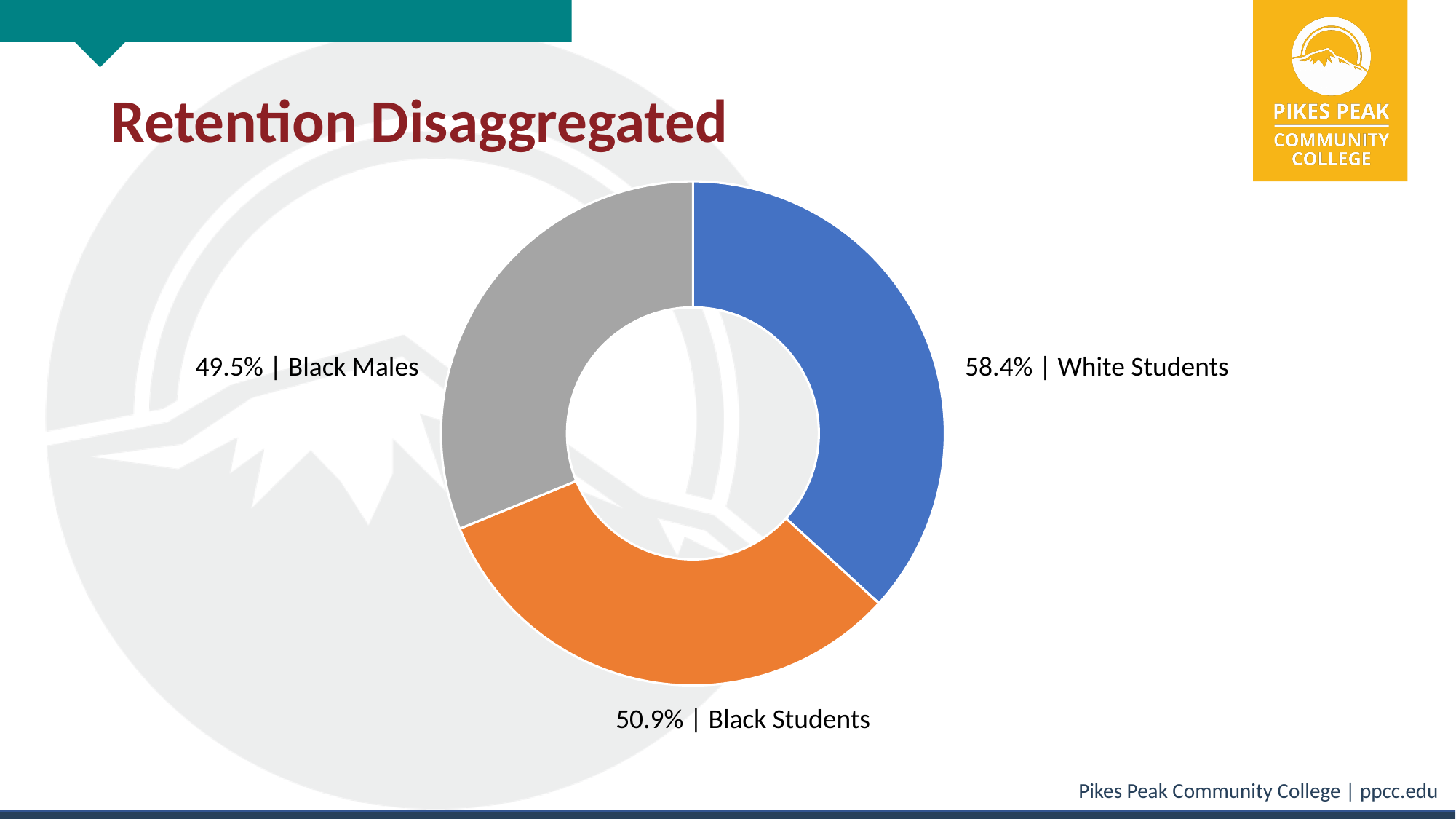
What is the difference between the retention values for White Students and Black Students? 7.5 percentage points What kind of chart is shown on the slide? Doughnut (pie) chart What is the retention value shown for Black Males? 49.5% What colour is the segment for Black Students? Orange Which group has the highest retention value on the chart? White Students What is the difference between the retention values for White Students and Black Males? 8.9 percentage points What is the retention value shown for White Students? 58.4% What is the difference between the retention values for Black Students and Black Males? 1.4 percentage points Which group has the lowest retention value on the chart? Black Males What is the retention value shown for Black Students? 50.9% How many groups are shown on the chart? 3 Which has the larger retention value, Black Students or Black Males? Black Students